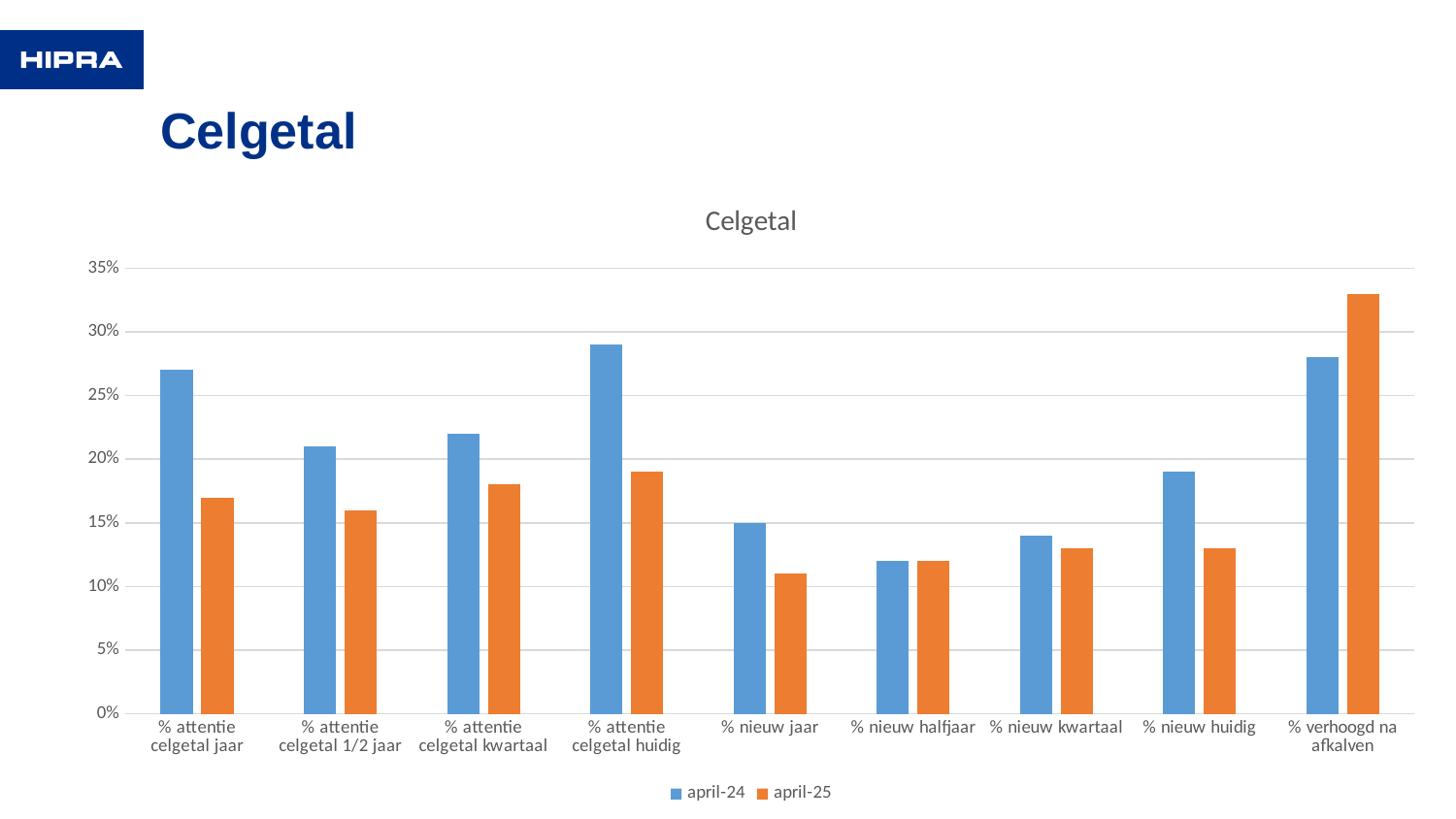
For % attentie celgetal jaar, which series has the larger value, april-24 or april-25? april-24 How many categories are shown on the x axis of the chart? 9 Is the april-24 value for % attentie celgetal jaar greater or less than 25%? greater What is the title of the chart? Celgetal Is the april-25 value for % verhoogd na afkalven greater or less than 30%? greater What kind of chart is shown on the slide? bar chart How many series does the chart's legend list? 2 Which category has the highest april-25 value? % verhoogd na afkalven Which series is shown in orange in the chart? april-25 For % verhoogd na afkalven, which series has the larger value, april-24 or april-25? april-25 Is the april-24 value for % attentie celgetal kwartaal greater or less than 20%? greater